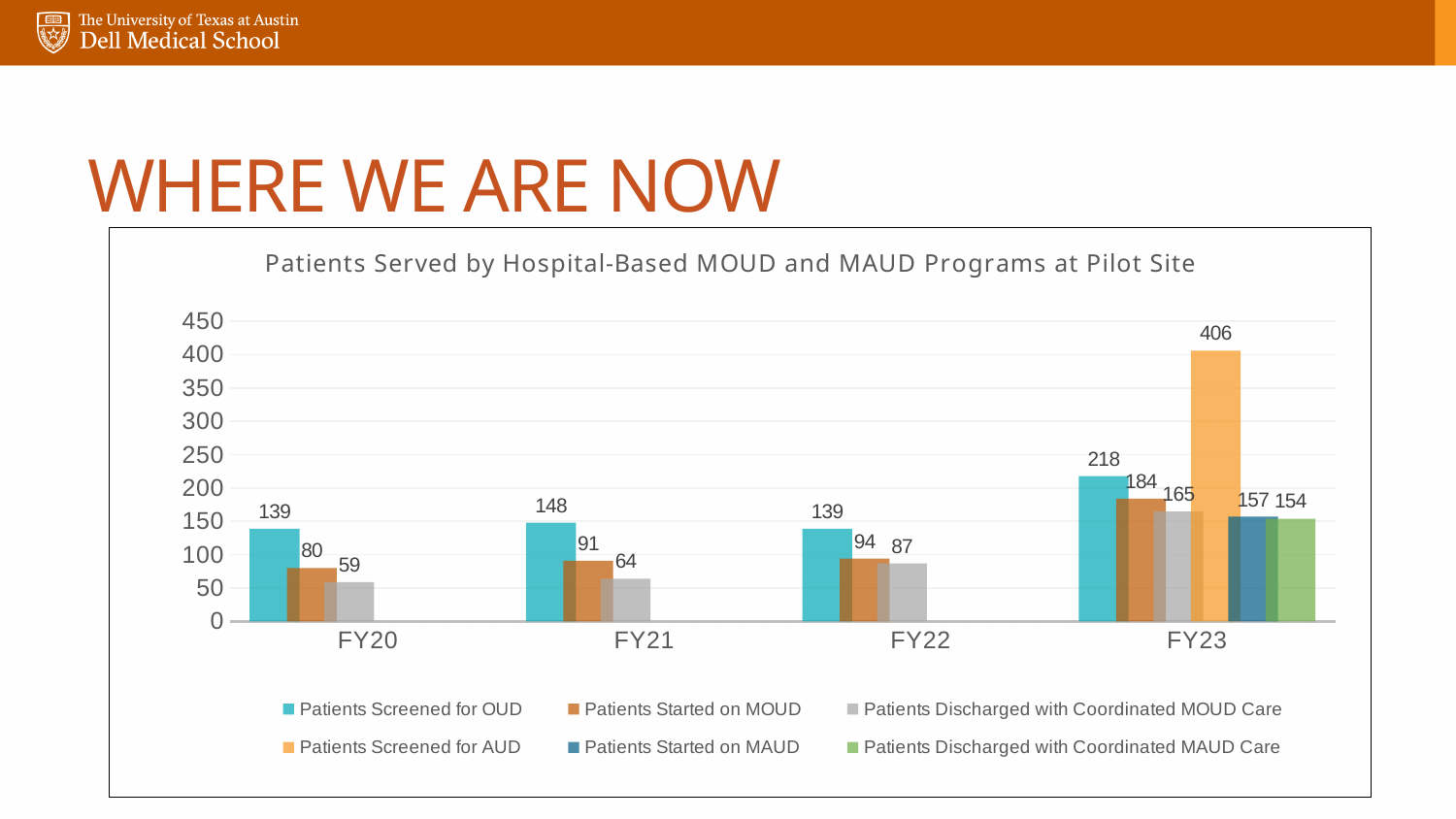
In which fiscal year is the value for Patients Discharged with Coordinated MOUD Care lowest? FY20 What is the title of the chart? Patients Served by Hospital-Based MOUD and MAUD Programs at Pilot Site What is the difference between Patients Screened for AUD and Patients Screened for OUD in FY23? 188 What kind of chart is shown on the slide? Bar chart How many fiscal years are shown on the x axis? 4 What is the value for Patients Screened for AUD in FY23? 406 What is the value for Patients Screened for OUD in FY23? 218 What is the value for Patients Started on MOUD in FY21? 91 In which fiscal year is the value for Patients Screened for OUD highest? FY23 Which is larger in FY22: Patients Started on MOUD or Patients Discharged with Coordinated MOUD Care? Patients Started on MOUD What is the value for Patients Discharged with Coordinated MOUD Care in FY20? 59 How many series does the legend list? 6